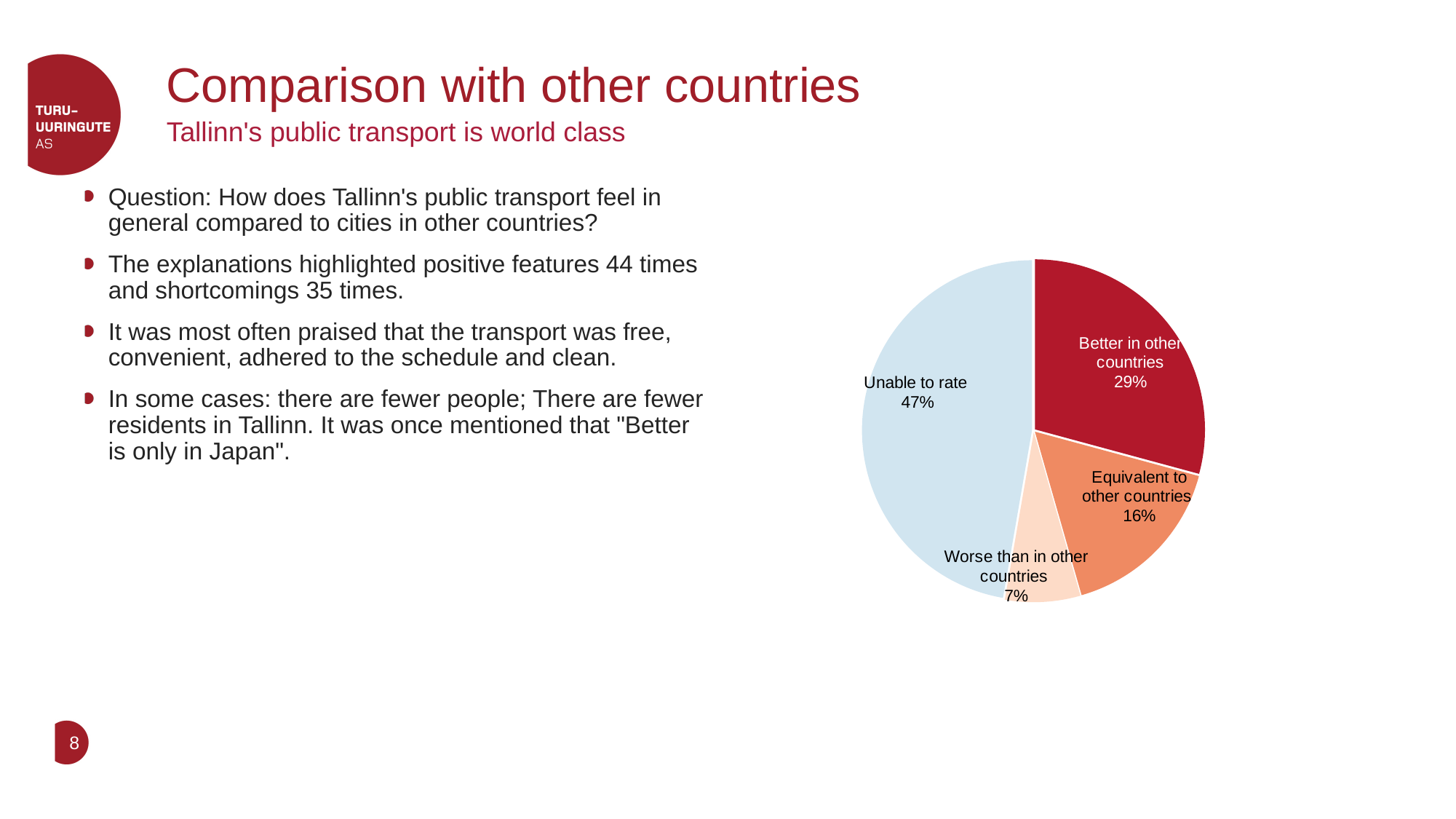
How many slices does the pie chart have? 4 What share of the pie is labelled "Worse than in other countries"? 7% Which is larger: "Better in other countries" or "Equivalent to other countries"? Better in other countries What share of the pie is labelled "Unable to rate"? 47% What share of the pie is labelled "Better in other countries"? 29% What kind of chart is shown on the slide? Pie chart What is the difference in percentage points between "Better in other countries" and "Worse than in other countries"? 22 percentage points Which slice of the pie is the smallest? Worse than in other countries Which slice of the pie is the largest? Unable to rate What colour is the "Better in other countries" slice? Dark red What is the difference in percentage points between "Unable to rate" and "Better in other countries"? 18 percentage points